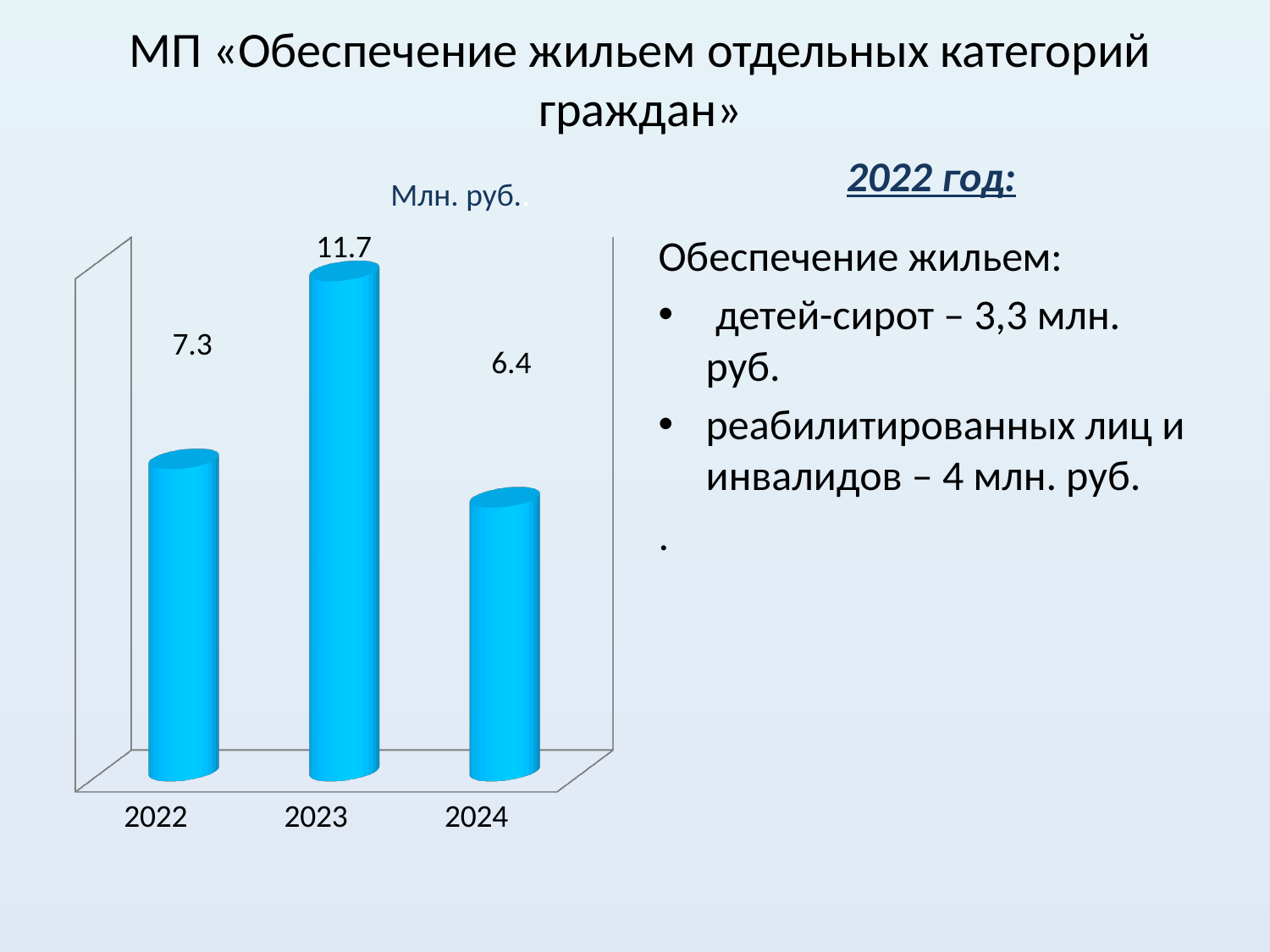
What is the difference between the values for 2022 and 2024? 0.9 What is the value for 2022? 7.3 Does the value rise or fall from 2023 to 2024? fall Which is larger, the value for 2022 or the value for 2024? 2022 What kind of chart is shown on the slide? bar chart Which year has the lowest value? 2024 What unit is shown above the chart? Млн. руб. What is the difference between the values for 2023 and 2022? 4.4 What is the value for 2024? 6.4 What is the value for 2023? 11.7 How many years are shown on the x axis? 3 Which year has the highest value? 2023